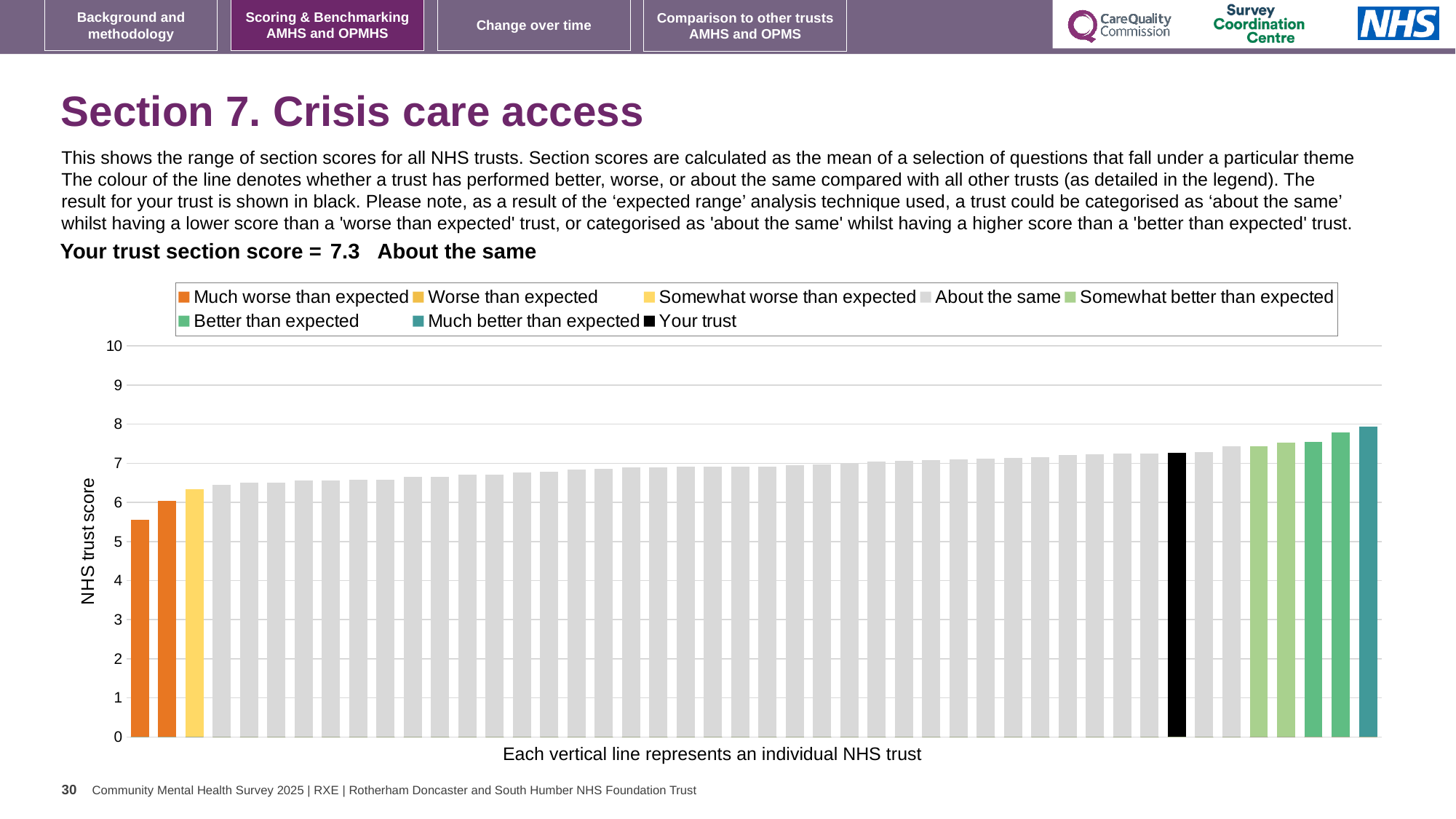
How many entries does the chart legend list? 8 Which legend category does your trust fall into according to the slide? About the same Is the value of the highest bar in the chart greater or less than 7? greater How many bars are coloured as 'Much worse than expected'? 2 Do the bar values rise or fall from left to right along the x axis? rise Is the value for your trust's bar greater or less than 7? greater Which legend category does the shortest bar in the chart belong to? Much worse than expected What is the label on the vertical axis of the chart? NHS trust score What is the section score for your trust shown on the slide? 7.3 What type of chart is shown on the slide? bar chart Is the value of the lowest bar in the chart greater or less than 6? less Which legend category does the tallest bar in the chart belong to? Much better than expected